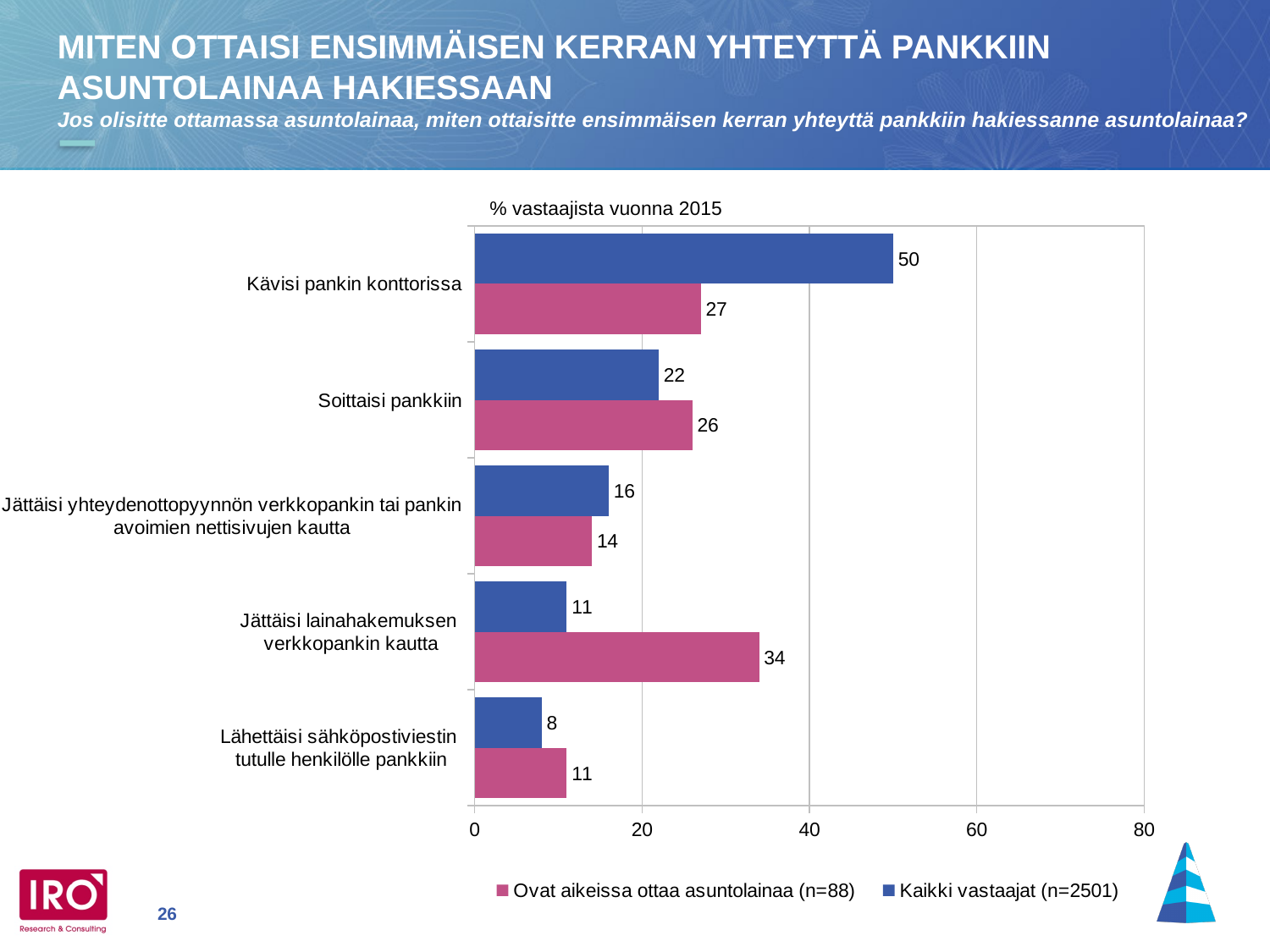
What is the difference between the 'Kaikki vastaajat (n=2501)' and 'Ovat aikeissa ottaa asuntolainaa (n=88)' values for 'Kävisi pankin konttorissa'? 23 What is the value for 'Kävisi pankin konttorissa' in the 'Kaikki vastaajat (n=2501)' series? 50 How many categories are shown on the chart? 5 What is the value for 'Jättäisi lainahakemuksen verkkopankin kautta' in the 'Ovat aikeissa ottaa asuntolainaa (n=88)' series? 34 What kind of chart is shown on the slide? Bar chart For 'Jättäisi lainahakemuksen verkkopankin kautta', which series has the larger value? Ovat aikeissa ottaa asuntolainaa (n=88) What is the value for 'Soittaisi pankkiin' in the 'Kaikki vastaajat (n=2501)' series? 22 How many series does the legend list? 2 Is the value for 'Kävisi pankin konttorissa' in the 'Kaikki vastaajat (n=2501)' series greater or less than 40? greater Which category has the highest value in the 'Kaikki vastaajat (n=2501)' series? Kävisi pankin konttorissa Which category has the lowest value in the 'Ovat aikeissa ottaa asuntolainaa (n=88)' series? Lähettäisi sähköpostiviestin tutulle henkilölle pankkiin What is the title of the chart? % vastaajista vuonna 2015